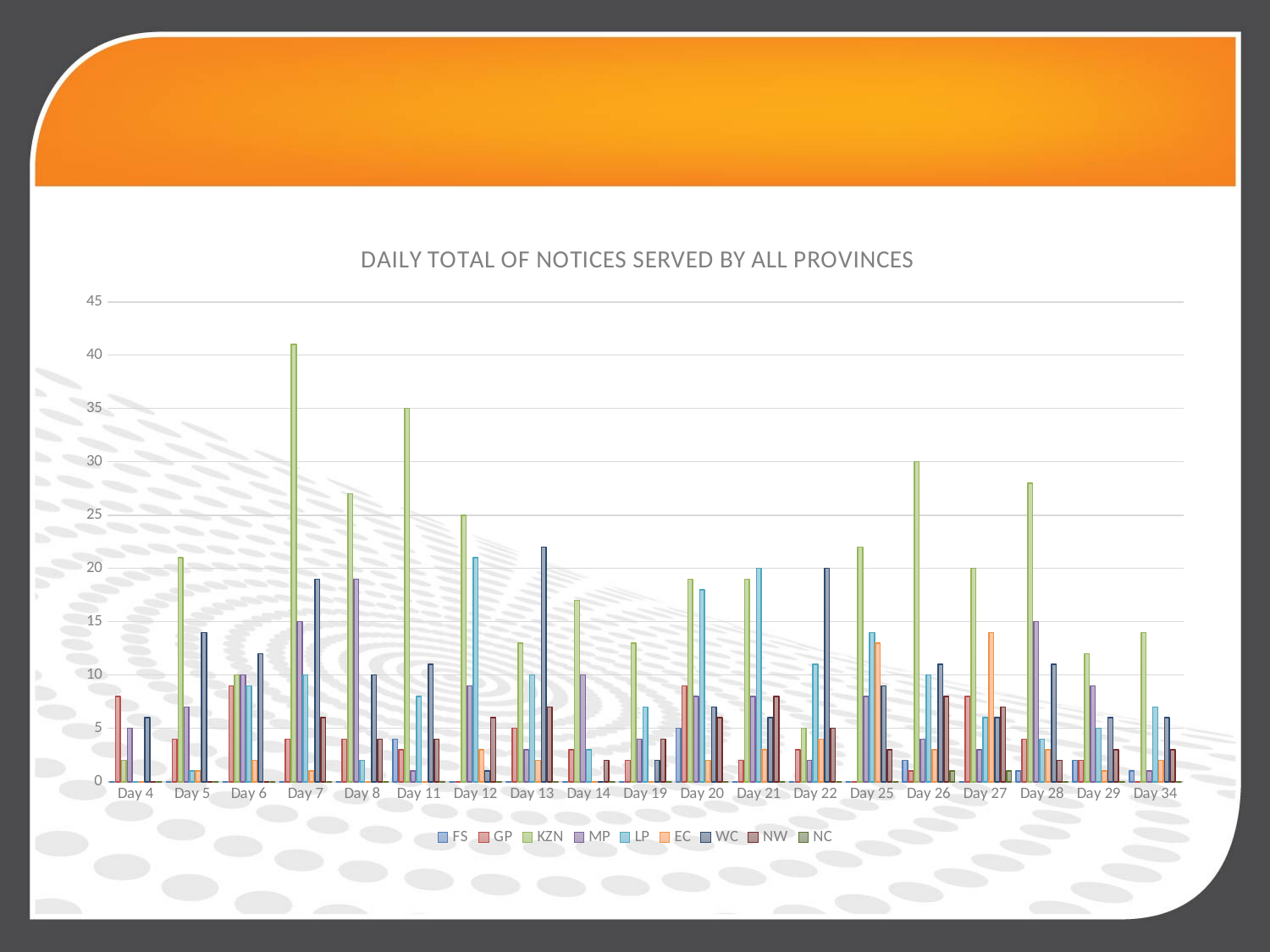
Which is larger, the KZN value on Day 26 or the KZN value on Day 25? Day 26 How many series does the legend list? 9 What kind of chart is shown on the slide? bar chart How many day categories are shown on the x axis? 19 Is the value for GP on Day 4 greater or less than 5? greater Is the value for MP on Day 28 greater or less than 10? greater What is the title of the chart? DAILY TOTAL OF NOTICES SERVED BY ALL PROVINCES Is the value for KZN on Day 7 greater or less than 40? greater Which is larger, the KZN value on Day 7 or the KZN value on Day 11? Day 7 On which day is the KZN bar the highest? Day 7